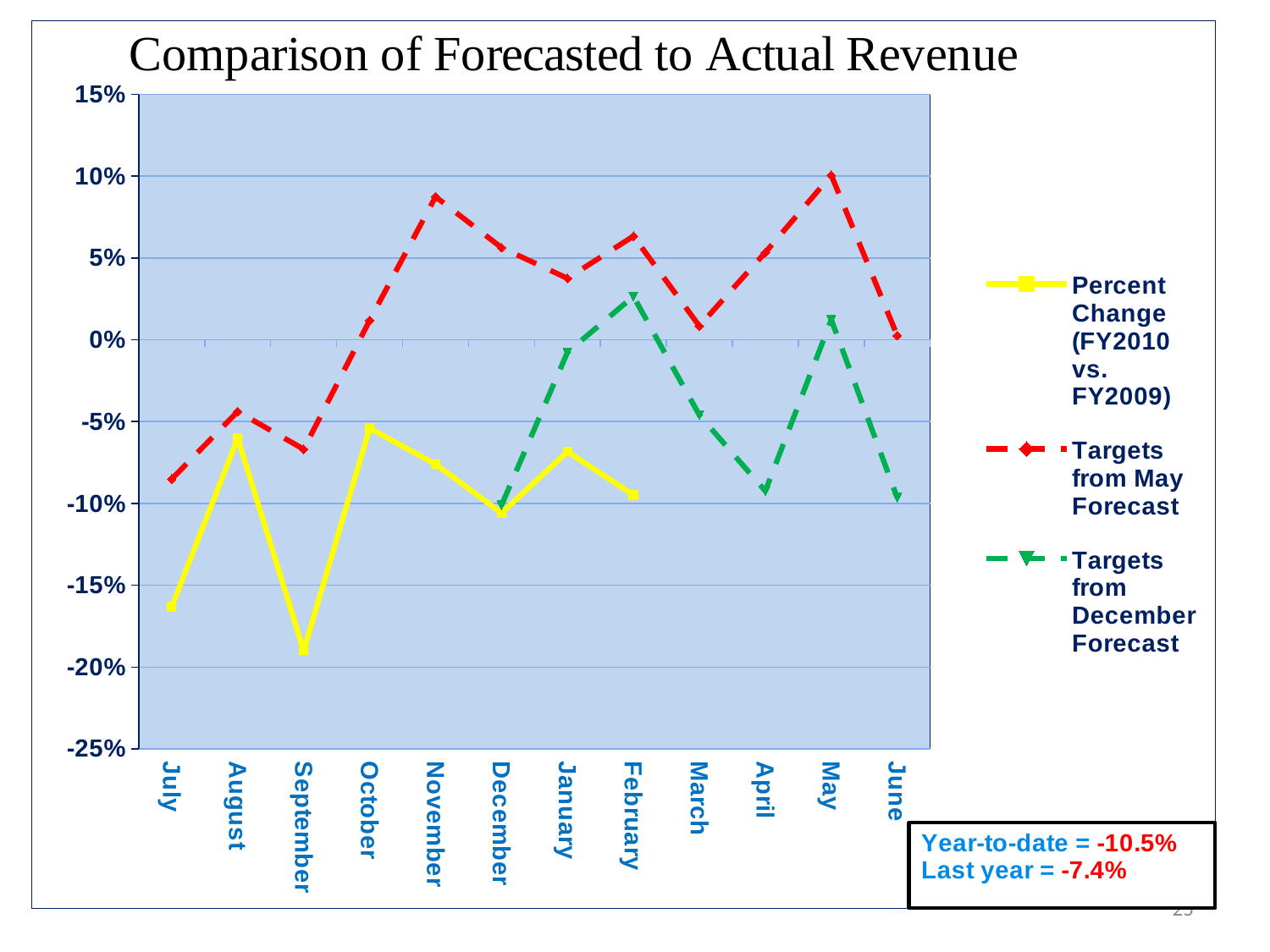
What is the title of the chart? Comparison of Forecasted to Actual Revenue How many months are shown along the x axis? 12 In which month is the Percent Change (FY2010 vs. FY2009) series at its lowest? September How many series does the legend list? 3 In which month does the Targets from December Forecast series reach its highest value? February Is the Targets from May Forecast value for November greater or less than 5%? greater Is the Percent Change (FY2010 vs. FY2009) value for July greater or less than -15%? less What kind of chart is shown on the slide? Line chart Is the Targets from December Forecast value for April greater or less than -5%? less Does the Percent Change (FY2010 vs. FY2009) series rise or fall from August to September? Fall In which month does the Targets from May Forecast series reach its highest value? May In August, which is higher: Percent Change (FY2010 vs. FY2009) or Targets from May Forecast? Targets from May Forecast